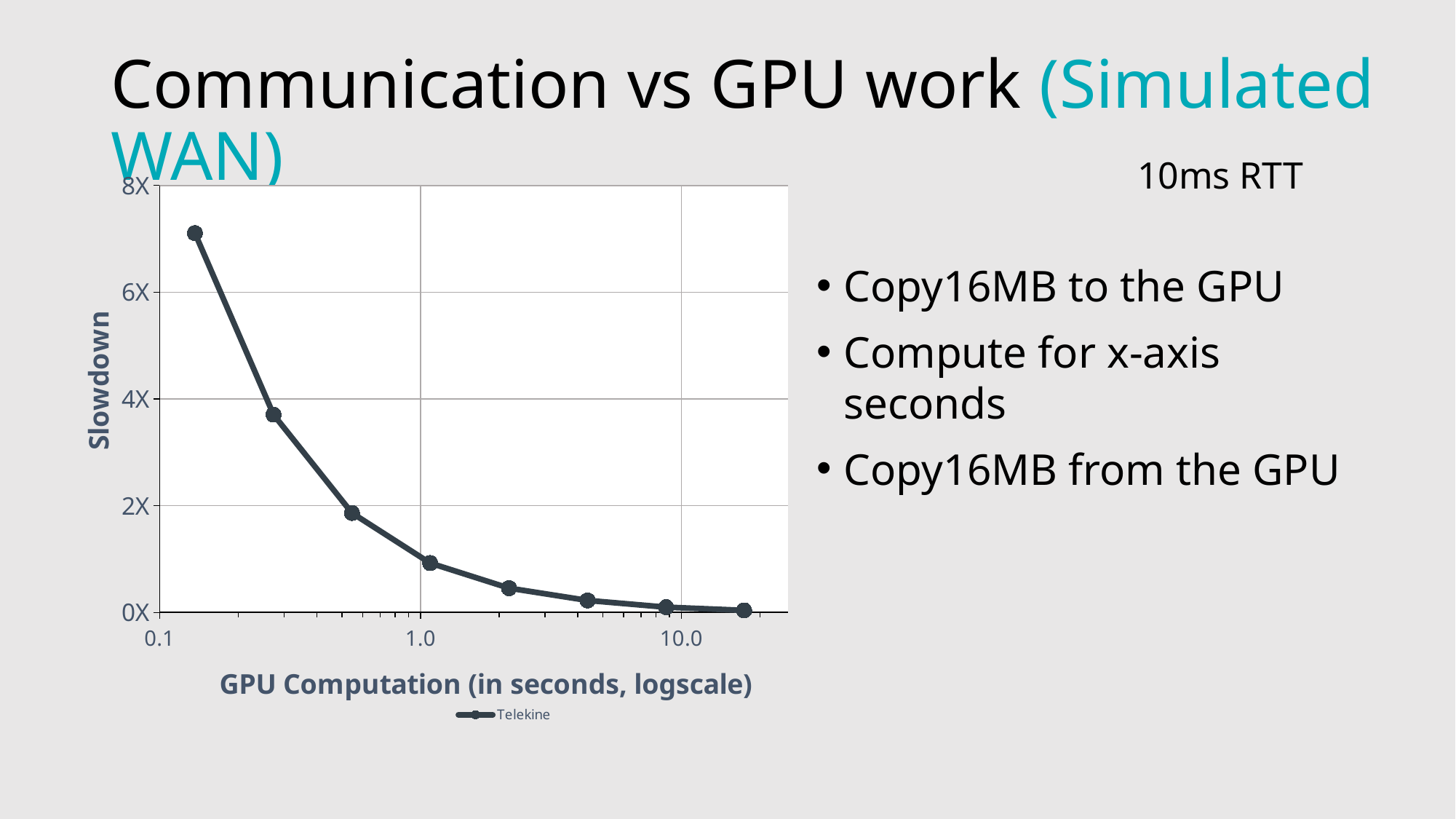
Is the slowdown for the rightmost data point greater or less than 2X? less What is the name of the series shown in the chart legend? Telekine How many series does the chart legend list? 1 Does the slowdown rise or fall as GPU computation time increases along the x axis? fall Which data point has the highest slowdown: the one with the smallest GPU computation time or the one with the largest? the one with the smallest GPU computation time How many data points are plotted on the Telekine line? 8 Is the slowdown for the second data point from the left greater or less than 2X? greater Is the slowdown for the leftmost data point (smallest GPU computation time) greater or less than 6X? greater Which has a larger slowdown: the leftmost data point or the rightmost data point? the leftmost data point What kind of chart is shown on the slide? line chart What is the title of the x axis of the chart? GPU Computation (in seconds, logscale)